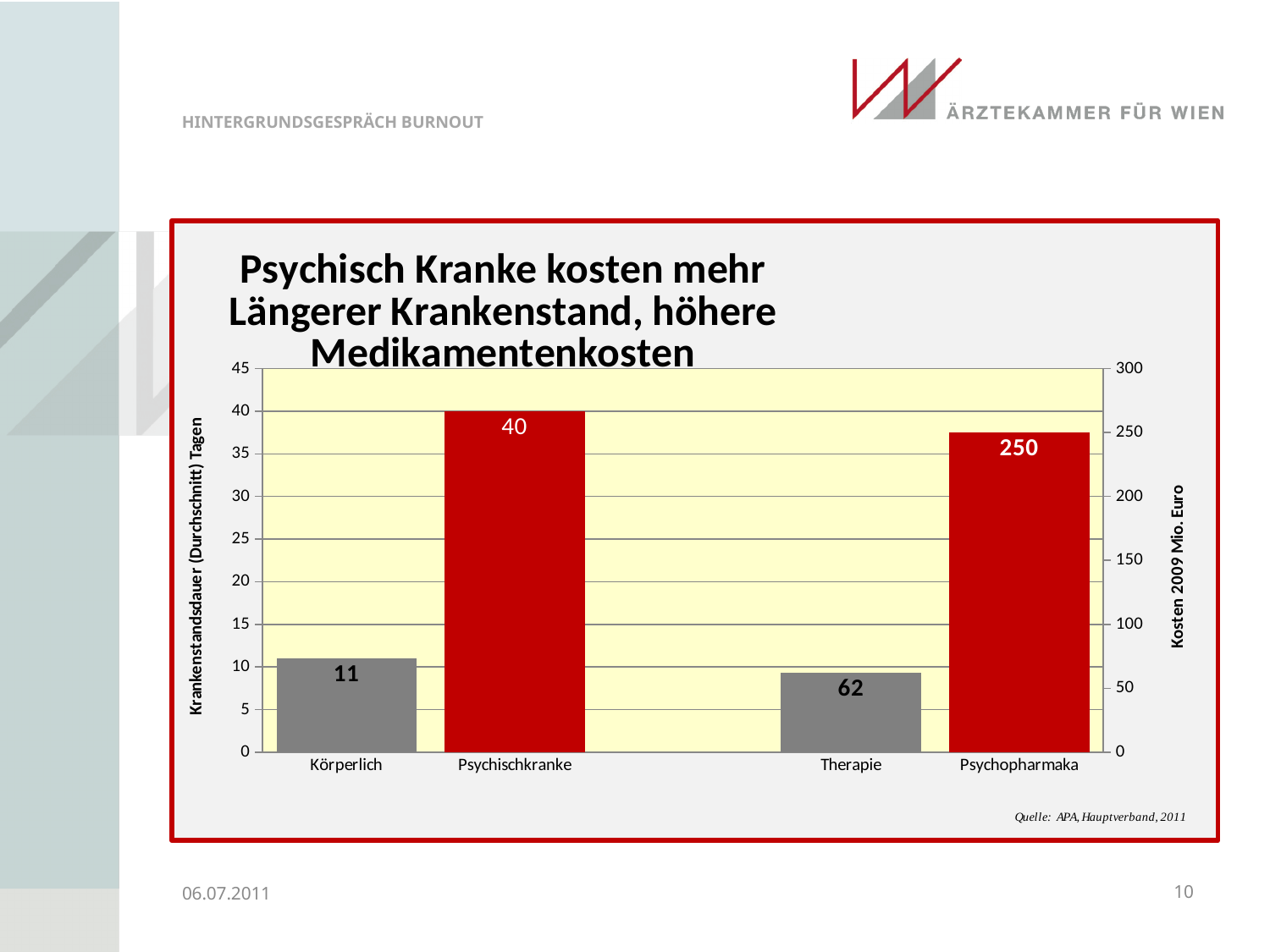
How many categories are shown on the x axis? 4 What is the label of the right-hand vertical axis? Kosten 2009 Mio. Euro Is the value for Psychopharmaka greater or less than 200 on the right axis? greater What is the value shown for Psychischkranke? 40 What is the value shown for Psychopharmaka? 250 What is the value shown for Therapie? 62 What is the value shown for Körperlich? 11 What is the difference between the values for Psychopharmaka and Therapie? 188 Which has the larger value, Psychopharmaka or Therapie? Psychopharmaka What is the difference between the values for Psychischkranke and Körperlich? 29 What kind of chart is shown on the slide? bar chart Which has the smaller value, Körperlich or Psychischkranke? Körperlich